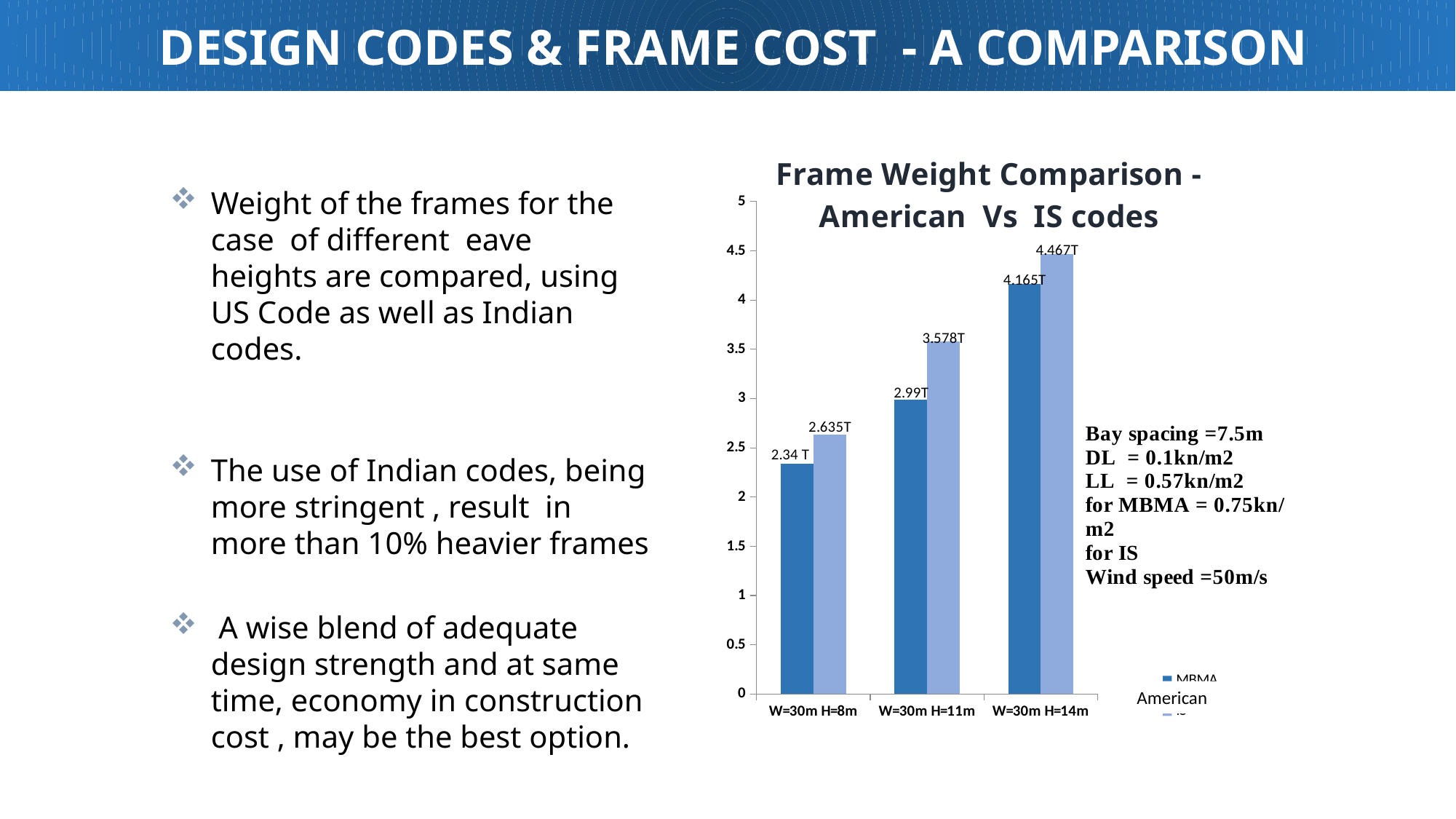
What is the difference between the IS code bar and the MBMA bar at W=30m H=8m? 0.295 T How many eave-height categories are shown on the x axis? 3 At W=30m H=11m, which bar is larger, the darker blue (MBMA) or the lighter blue (IS code)? lighter blue (IS code) What is the frame weight for the lighter blue (IS code) bar at W=30m H=14m? 4.467T Do the frame weights rise or fall as the eave height increases from H=8m to H=14m? rise What type of chart is used for the Frame Weight Comparison? bar chart What is the value of the lighter blue (IS code) bar at W=30m H=11m? 3.578T What is the lowest frame weight value labelled on the chart? 2.34 T What is the value of the darker blue (MBMA) bar at W=30m H=11m? 2.99T Which category has the highest frame weight shown on the chart? W=30m H=14m What is the frame weight for the MBMA (American) series at W=30m H=8m? 2.34 T What is the difference between the two bars at W=30m H=14m? 0.302T